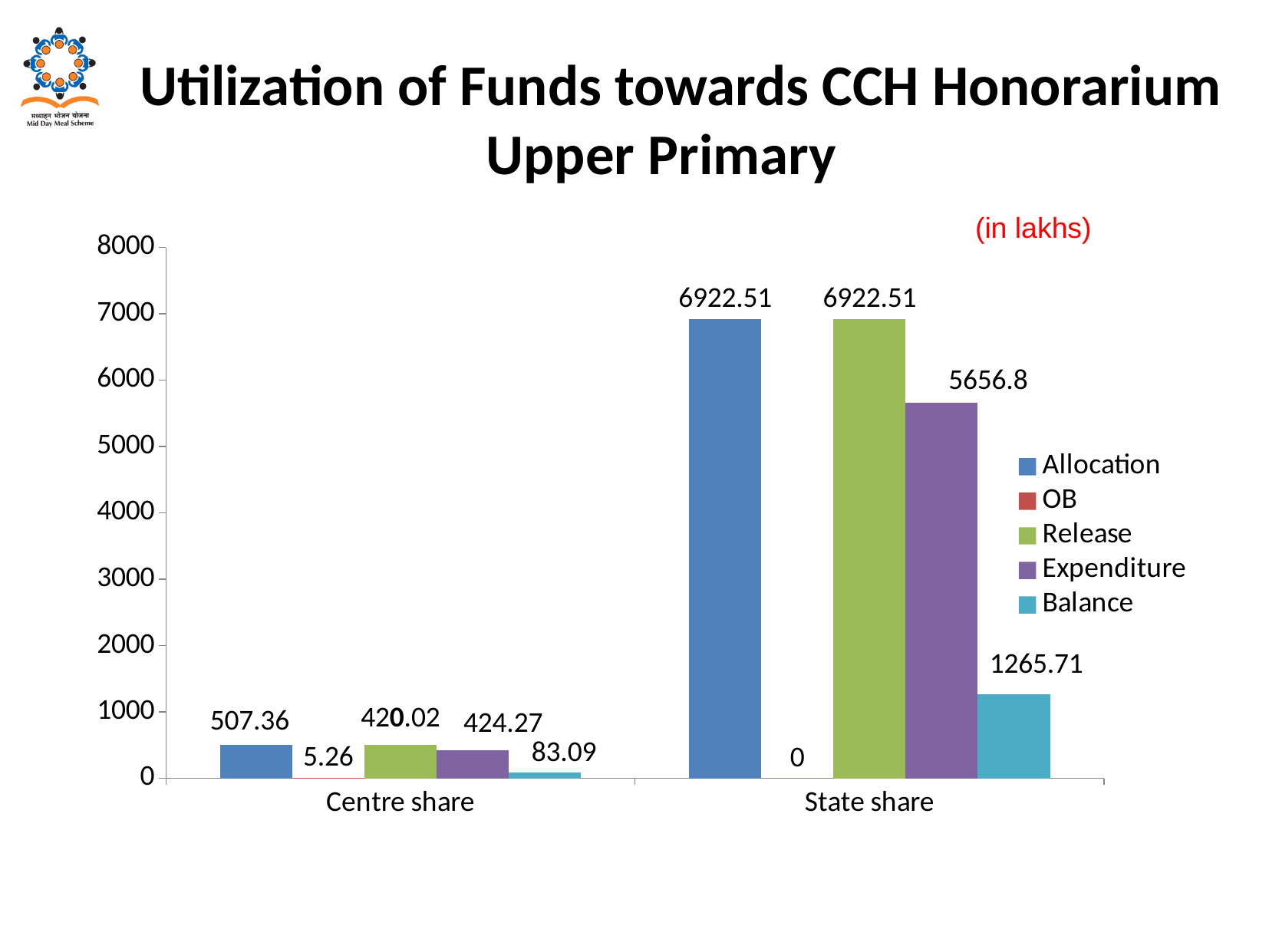
What is the Expenditure value for State share? 5656.8 Which series has the lowest value for State share? OB What is the Allocation value for State share? 6922.51 What kind of chart is shown on the slide? Bar chart What is the OB value for Centre share? 5.26 What is the Balance value for Centre share? 83.09 Which series has the highest value for Centre share? Allocation What is the difference between Release and Expenditure for State share? 1265.71 Is the Balance value for State share greater or less than 1000? greater How many categories are shown on the x axis? 2 How many series does the legend list? 5